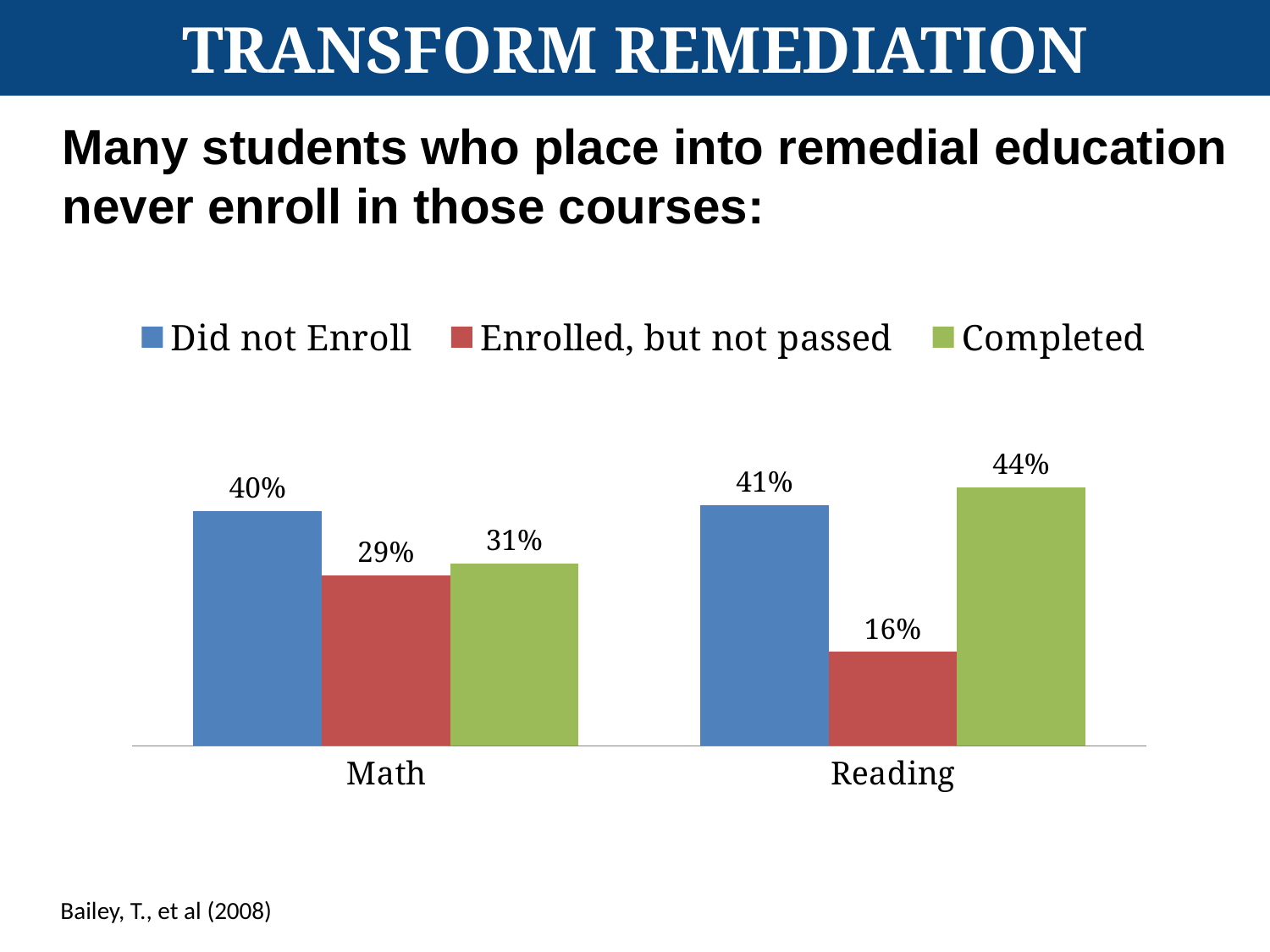
What colour represents the Completed series? Green What percentage of Math students did not enroll? 40% How many series does the legend list? 3 What is the difference between Did not Enroll and Completed for Math? 9% Which is larger: Completed for Math or Completed for Reading? Completed for Reading What is the value for Completed in Reading? 44% Which series has the lowest value for Math? Enrolled, but not passed Which series has the highest value for Reading? Completed How many categories are shown on the x axis? 2 What kind of chart is shown on the slide? Bar chart What is the difference between Enrolled, but not passed for Math and for Reading? 13% What is the value for Enrolled, but not passed in Reading? 16%